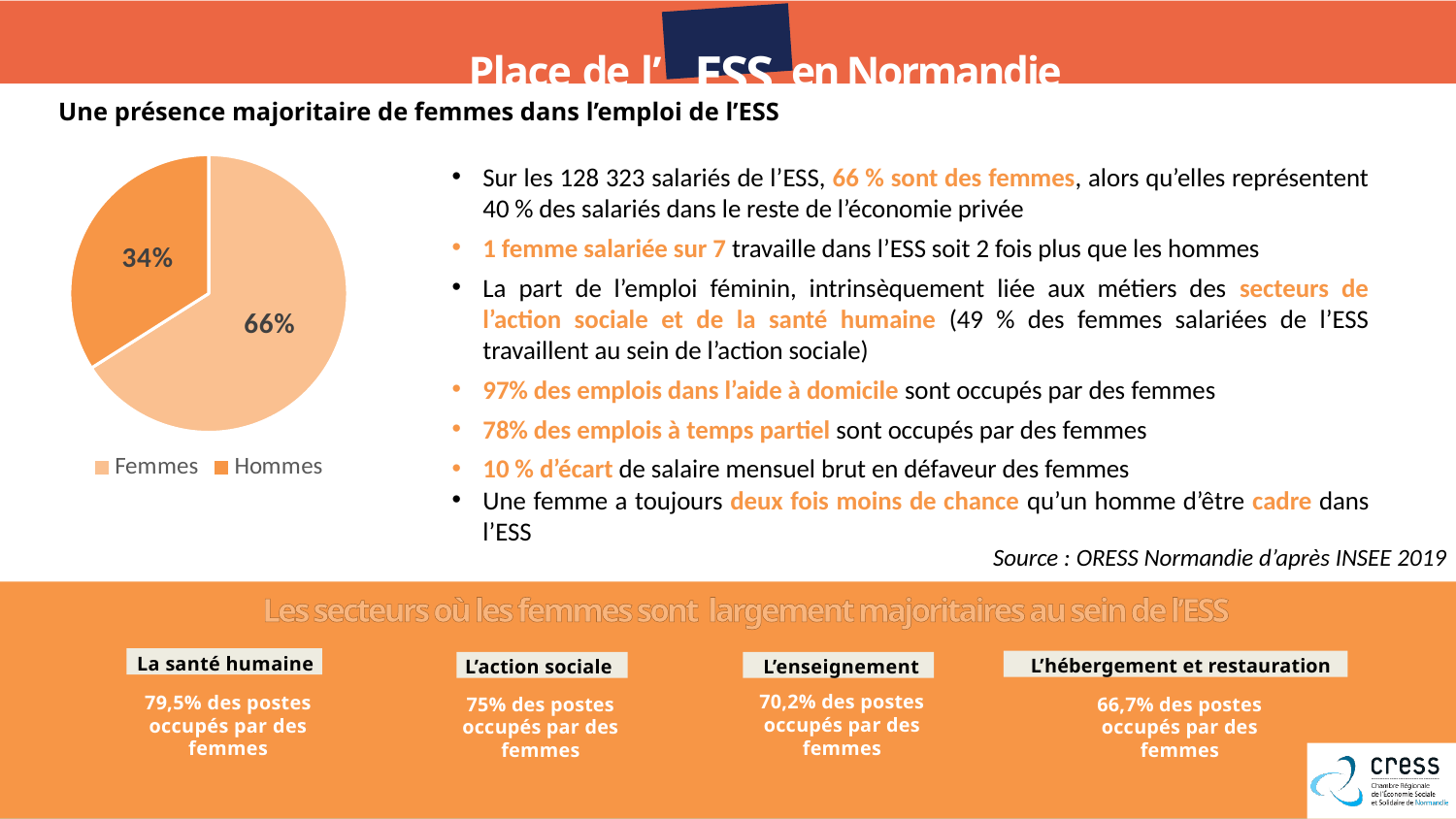
How many entries does the pie chart's legend list? 2 What is the difference in percentage points between the Femmes and Hommes slices of the pie chart? 32 In the pie chart, which is larger: the Femmes slice or the Hommes slice? Femmes In the pie chart, what share is shown for Femmes? 66% What is the total of the two slices shown in the pie chart? 100% Is the Hommes slice of the pie chart greater or less than 50%? less Which slice of the pie chart is the smallest? Hommes Which slice of the pie chart is the largest? Femmes How many slices does the pie chart have? 2 What are the two legend entries of the pie chart? Femmes and Hommes In the pie chart, what share is shown for Hommes? 34% What kind of chart is shown on the left of the slide? pie chart